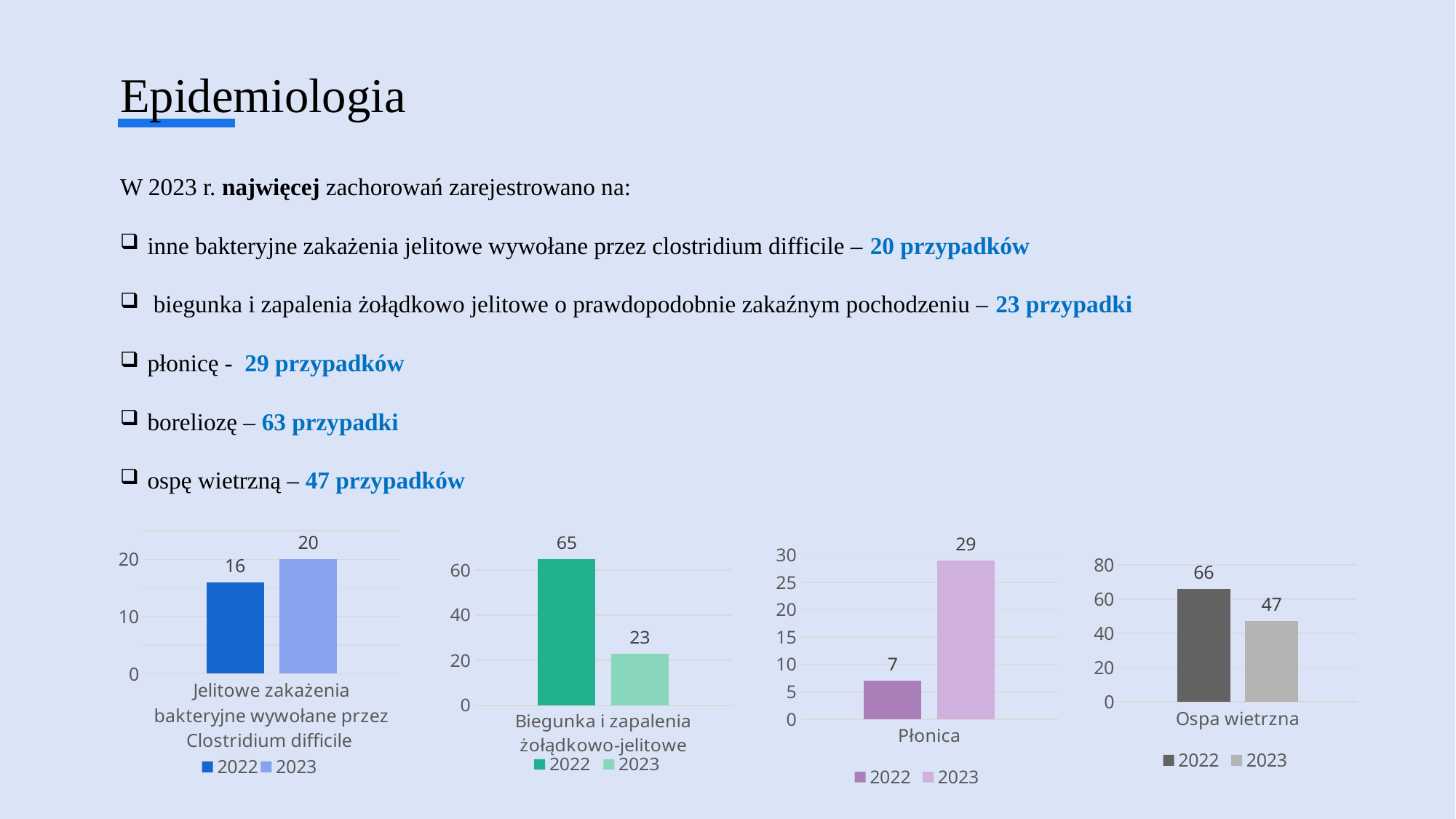
In the chart for Ospa wietrzna, which year has the lower value? 2023 In the chart for Płonica, what is the value for 2023? 29 In the chart for Ospa wietrzna, what is the value for 2022? 66 In the chart for Ospa wietrzna, what is the difference between the 2022 and 2023 values? 19 How many charts are shown on the slide? 4 In the chart for Płonica, which year has the higher value, 2022 or 2023? 2023 In the chart for Biegunka i zapalenia żołądkowo-jelitowe, what is the value for 2022? 65 In the chart for Jelitowe zakażenia bakteryjne wywołane przez Clostridium difficile, what is the value for 2023? 20 In the chart for Biegunka i zapalenia żołądkowo-jelitowe, what is the difference between the 2022 and 2023 values? 42 What kind of chart is the Biegunka i zapalenia żołądkowo-jelitowe chart? Bar chart How many series does the legend of the Płonica chart list? 2 In the chart for Jelitowe zakażenia bakteryjne wywołane przez Clostridium difficile, what is the value for 2022? 16